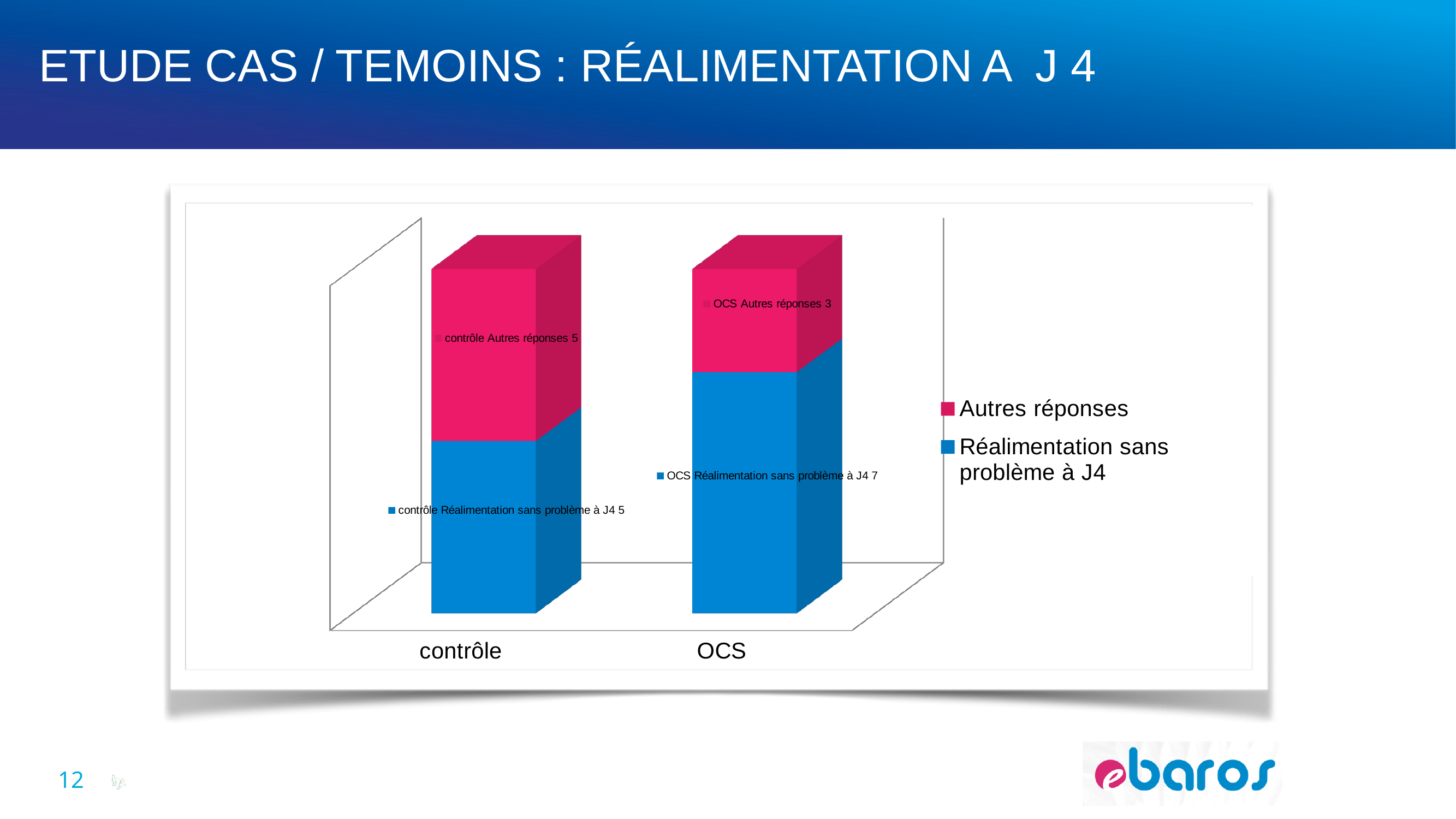
What is the difference between the Autres réponses values for contrôle and OCS? 2 What is the total of the stacked bar for contrôle? 10 What is the difference between the Réalimentation sans problème à J4 values for OCS and contrôle? 2 How many series does the legend list? 2 What is the value of Réalimentation sans problème à J4 for contrôle? 5 What is the value of Autres réponses for contrôle? 5 What is the total of the stacked bar for OCS? 10 Which category has the higher value for Réalimentation sans problème à J4, contrôle or OCS? OCS Which category has the higher value for Autres réponses, contrôle or OCS? contrôle How many categories are shown on the x axis? 2 What is the value of Autres réponses for OCS? 3 What is the value of Réalimentation sans problème à J4 for OCS? 7